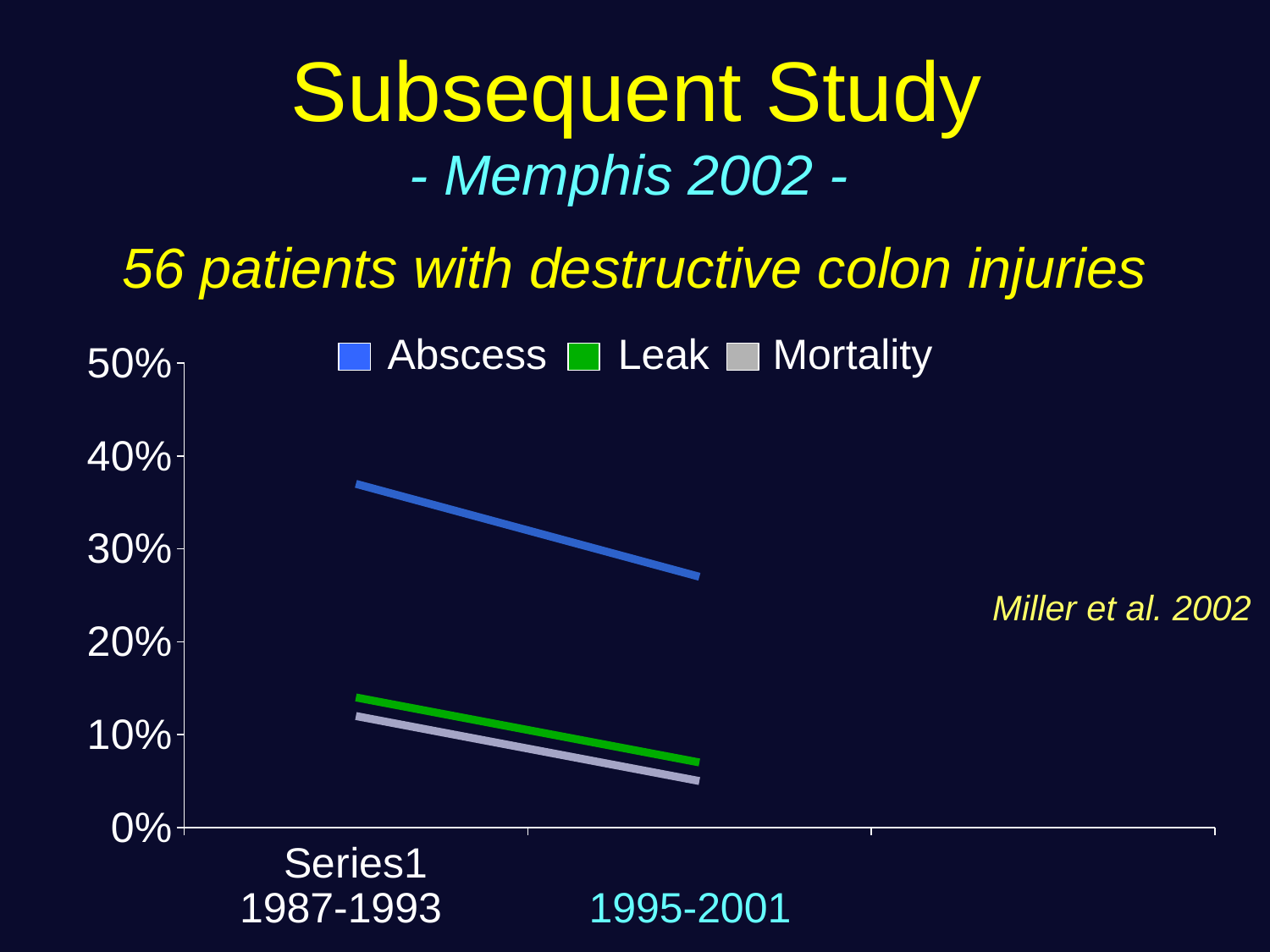
How many series does the legend list? 3 Which series are listed in the legend? Abscess, Leak, Mortality Is the Abscess value for 1995-2001 greater or less than 30%? less Is the Mortality value for 1995-2001 greater or less than 10%? less What colour is the Abscess line? blue Is the Leak value for 1987-1993 greater or less than 10%? greater How many time periods are shown on the x axis? 2 Which series has the highest value in 1995-2001? Abscess Does the Mortality rate rise or fall from 1987-1993 to 1995-2001? fall What kind of chart is shown on the slide? line chart Does the Abscess rate rise or fall from 1987-1993 to 1995-2001? fall